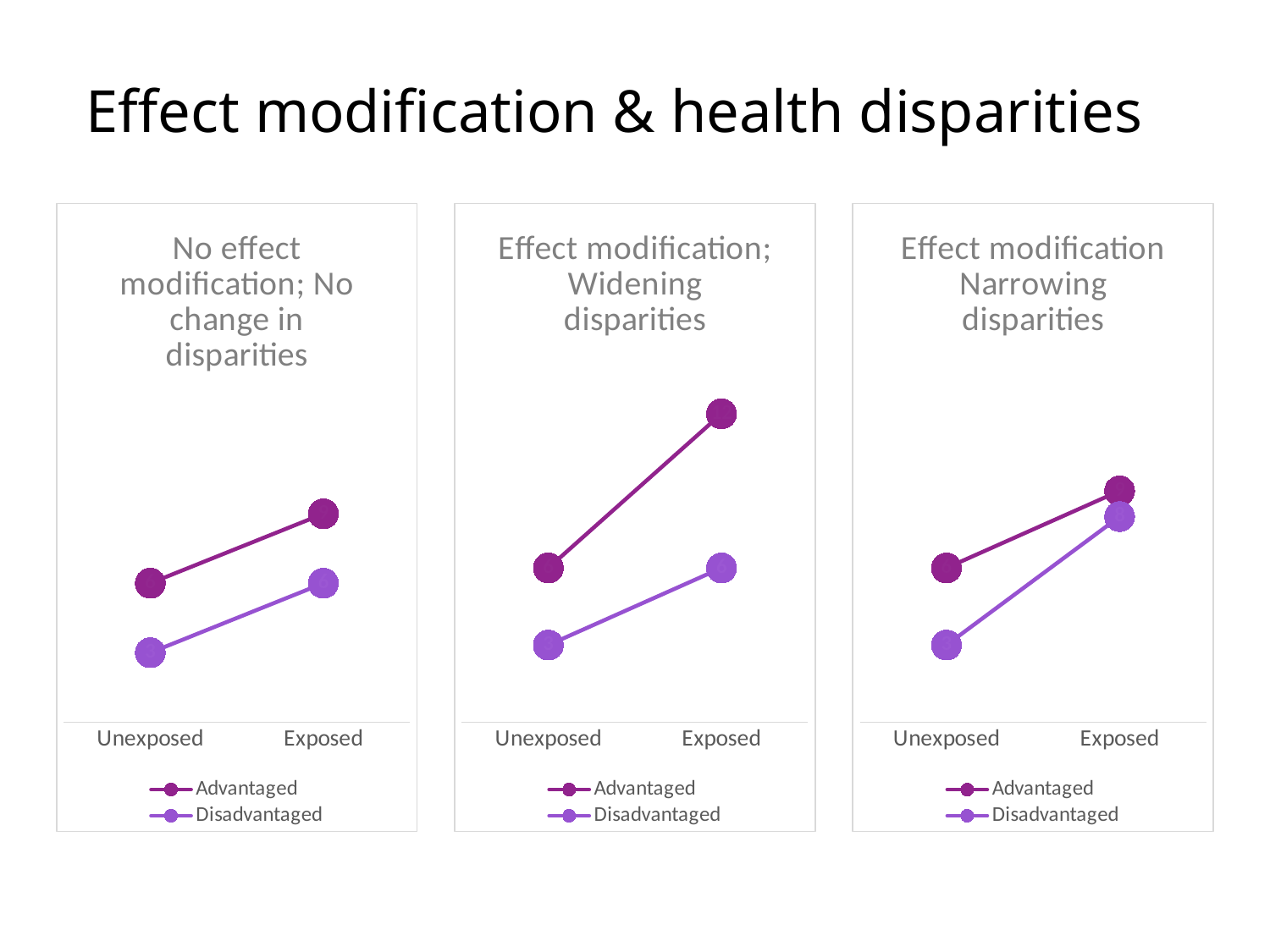
How many series does the legend list in the middle chart titled "Effect modification; Widening disparities"? 2 In the left chart titled "No effect modification; No change in disparities", which series has the higher value at Unexposed, Advantaged or Disadvantaged? Advantaged In the left chart titled "No effect modification; No change in disparities", does the Advantaged line rise or fall from Unexposed to Exposed? rise In the middle chart titled "Effect modification; Widening disparities", which series has the higher value at Unexposed, Advantaged or Disadvantaged? Advantaged In the right chart titled "Effect modification Narrowing disparities", which series has the lower value at Unexposed, Advantaged or Disadvantaged? Disadvantaged How many charts are shown on the slide? 3 How many categories are shown on the x axis of the right chart titled "Effect modification Narrowing disparities"? 2 In the right chart titled "Effect modification Narrowing disparities", does the Disadvantaged line rise or fall from Unexposed to Exposed? rise What are the two legend entries in the right chart titled "Effect modification Narrowing disparities"? Advantaged and Disadvantaged In the middle chart titled "Effect modification; Widening disparities", does the Disadvantaged line rise or fall from Unexposed to Exposed? rise What kind of chart is the left chart titled "No effect modification; No change in disparities"? line chart